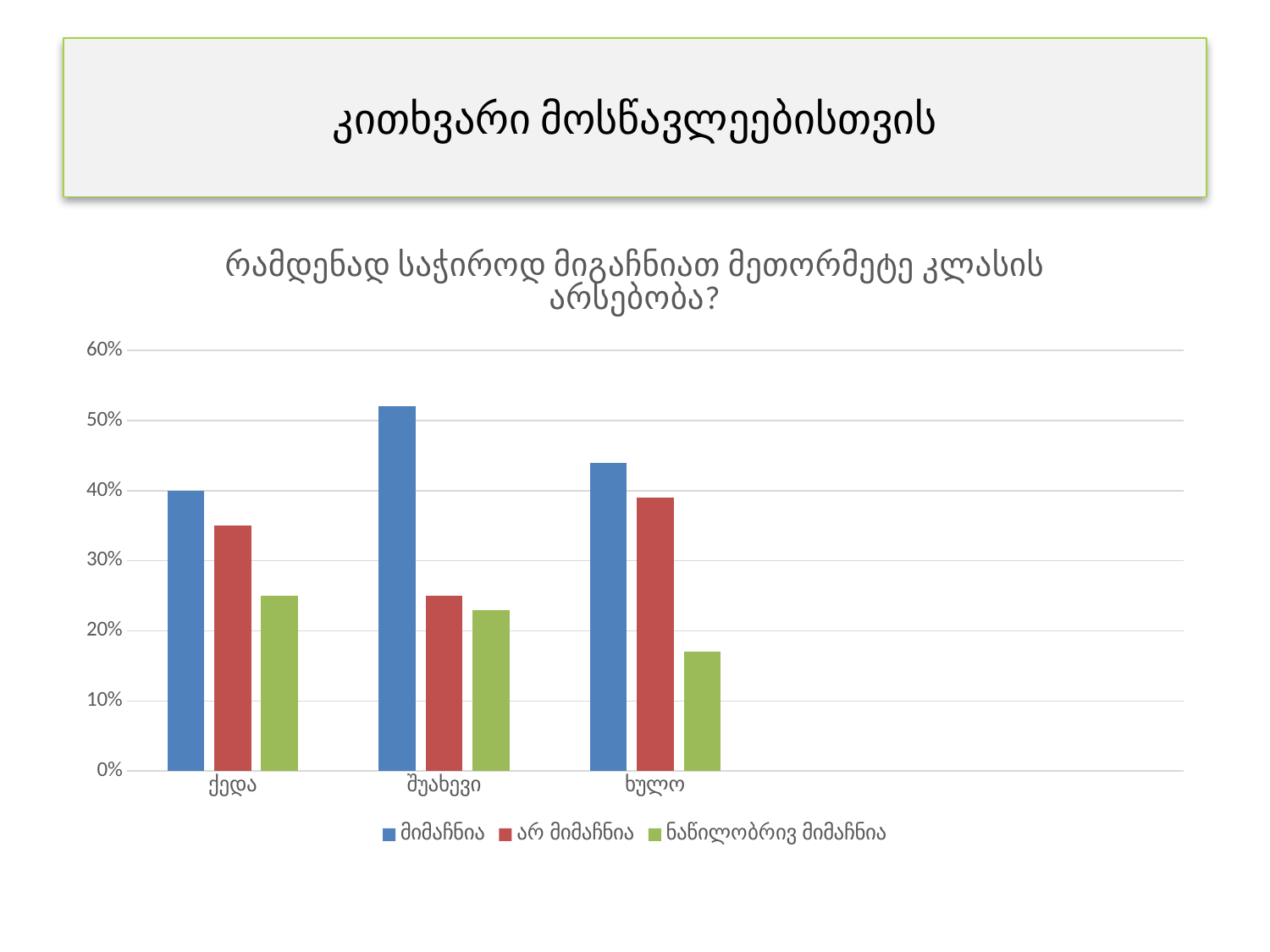
What is the title of the chart? რამდენად საჭიროდ მიგაჩნიათ მეთორმეტე კლასის არსებობა? How many series does the chart's legend list? 3 Which category has the larger value for არ მიმაჩნია: შუახევი or ხულო? ხულო Is the value for ნაწილობრივ მიმაჩნია in ხულო greater or less than 20%? less What kind of chart is shown on the slide? bar chart How many categories are shown on the x axis of the chart? 3 Is the value for არ მიმაჩნია in ქედა greater or less than 30%? greater Which category has the highest value for მიმაჩნია? შუახევი Which category has the lowest value for ნაწილობრივ მიმაჩნია? ხულო What colour represents ნაწილობრივ მიმაჩნია in the chart's legend? green Is the value for მიმაჩნია in შუახევი greater or less than 50%? greater In ქედა, which is larger: მიმაჩნია or არ მიმაჩნია? მიმაჩნია